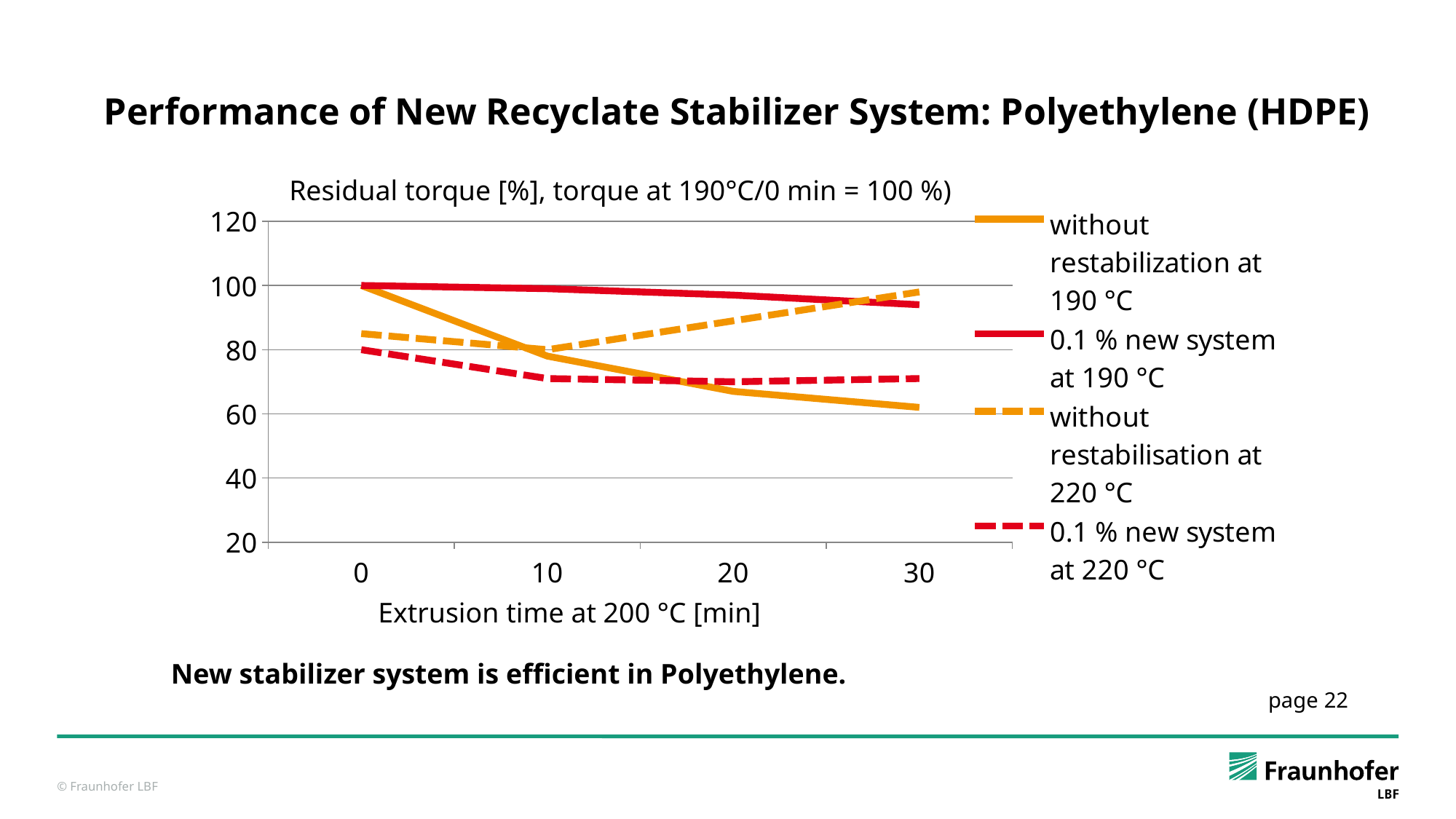
Is the residual torque for '0.1 % new system at 190 °C' at 30 min greater or less than 80? greater Which series has the lowest residual torque at 30 min? without restabilization at 190 °C How many extrusion time points are labelled on the x axis? 4 What kind of chart is shown on the slide? line chart Is the residual torque for '0.1 % new system at 220 °C' at 20 min greater or less than 60? greater At 30 min, which series has the higher residual torque: '0.1 % new system at 190 °C' or 'without restabilization at 190 °C'? 0.1 % new system at 190 °C How many series does the legend list? 4 Between 10 and 30 min, does the residual torque for 'without restabilisation at 220 °C' rise or fall? rise Is the residual torque for 'without restabilization at 190 °C' at 30 min greater or less than 80? less Does the residual torque for 'without restabilization at 190 °C' rise or fall as extrusion time increases from 0 to 30 min? fall What is the x-axis title of the chart? Extrusion time at 200 °C [min] What is the residual torque for '0.1 % new system at 190 °C' at 0 min? 100